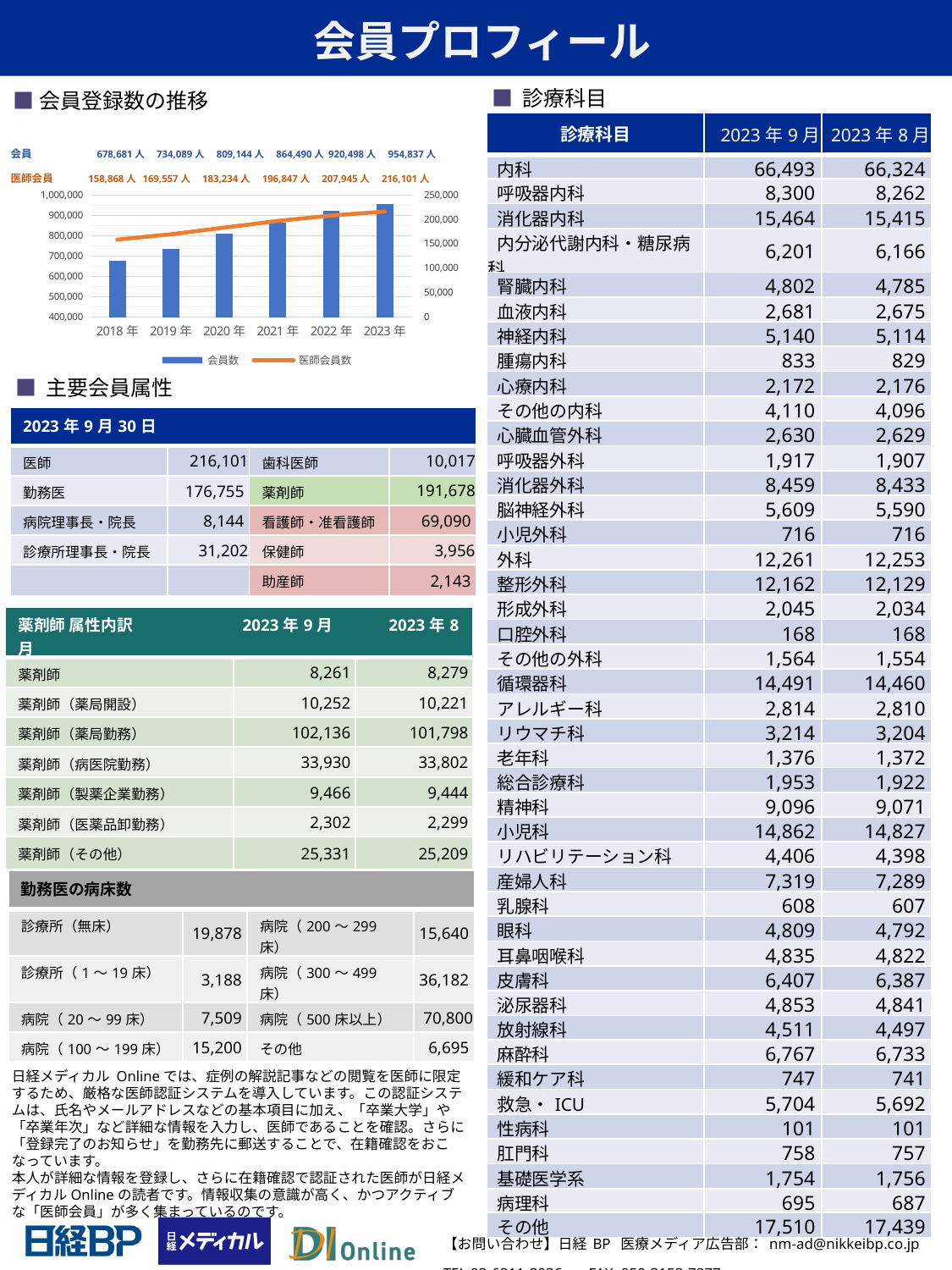
Do the 会員 values in the 会員登録数の推移 chart rise or fall from 2018年 to 2023年? rise In the 会員登録数の推移 chart, what is the 医師会員 value for 2022年? 207,945人 How many series does the legend of the 会員登録数の推移 chart list? 2 In the 会員登録数の推移 chart, what is the 会員 value for 2020年? 809,144人 In the 会員登録数の推移 chart, what is the difference between the 医師会員 values for 2021年 and 2020年? 13,613人 In the 会員登録数の推移 chart, what is the difference between the 会員 values for 2023年 and 2018年? 276,156人 In the 会員登録数の推移 chart, is the 会員 value for 2019年 larger or smaller than the 会員 value for 2021年? smaller How many years are shown on the x axis of the 会員登録数の推移 chart? 6 In the 会員登録数の推移 chart, which year has the highest 会員 value? 2023年 In the 会員登録数の推移 chart, which year has the lowest 医師会員 value? 2018年 In the 会員登録数の推移 chart, what is the 会員 value for 2023年? 954,837人 In the 会員登録数の推移 chart, what is the 医師会員 value for 2018年? 158,868人